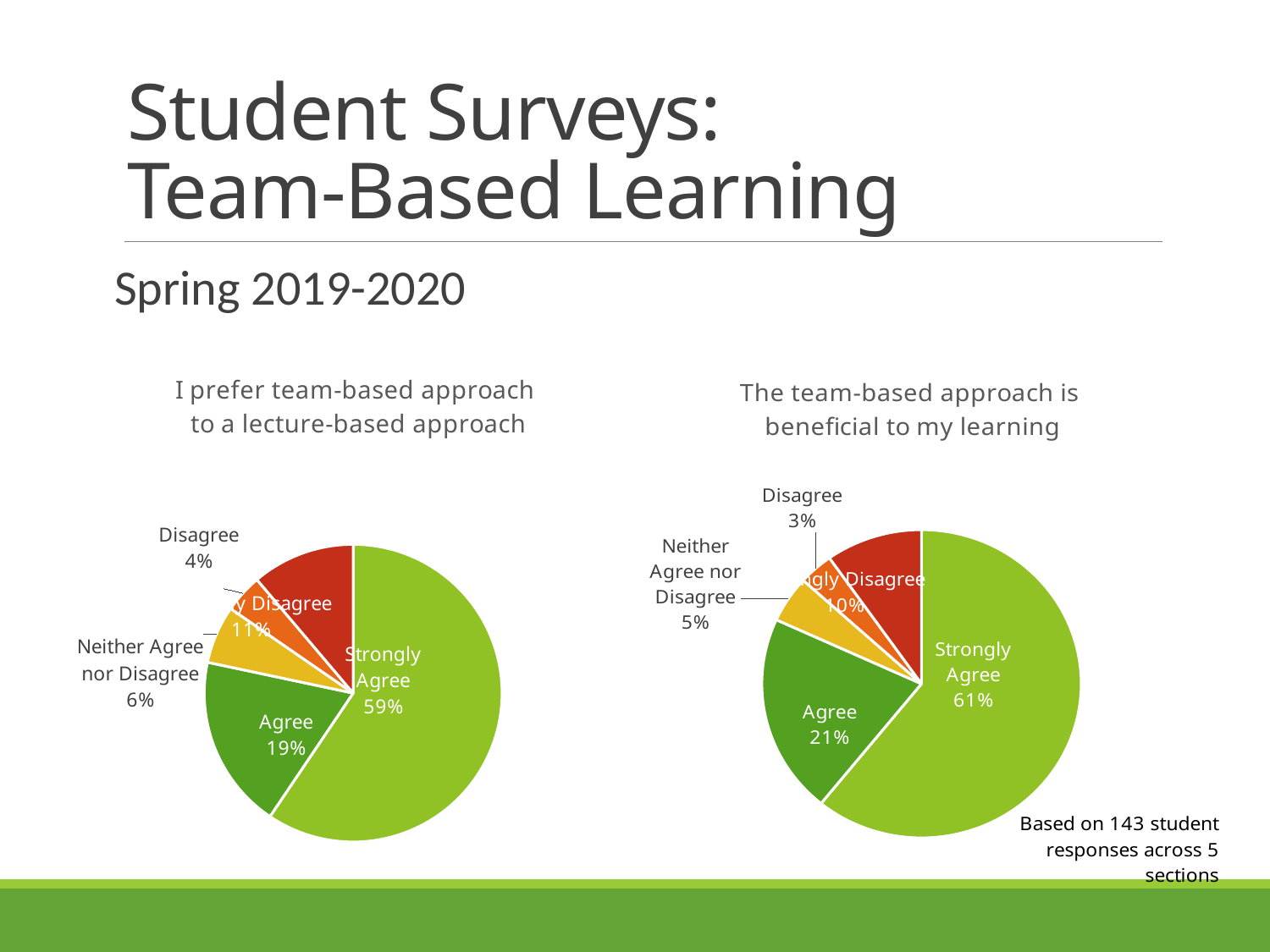
What kind of chart is used on the left side of the slide? Pie chart In the pie chart titled "The team-based approach is beneficial to my learning", what share of responses is Strongly Agree? 61% In the pie chart titled "I prefer team-based approach to a lecture-based approach", what share of responses is Disagree? 4% In the pie chart titled "The team-based approach is beneficial to my learning", what share of responses is Agree? 21% In the pie chart titled "The team-based approach is beneficial to my learning", what share of responses is Disagree? 3% In the pie chart titled "I prefer team-based approach to a lecture-based approach", what is the difference between the Strongly Agree and Agree shares? 40% In the pie chart titled "I prefer team-based approach to a lecture-based approach", what share of responses is Agree? 19% In the pie chart titled "The team-based approach is beneficial to my learning", which response has the smallest share? Disagree In the pie chart titled "The team-based approach is beneficial to my learning", which response has the largest share? Strongly Agree In the pie chart titled "The team-based approach is beneficial to my learning", which is larger: the Agree share or the Neither Agree nor Disagree share? Agree In the pie chart titled "I prefer team-based approach to a lecture-based approach", what share of responses is Neither Agree nor Disagree? 6% In the pie chart titled "I prefer team-based approach to a lecture-based approach", what share of responses is Strongly Agree? 59%